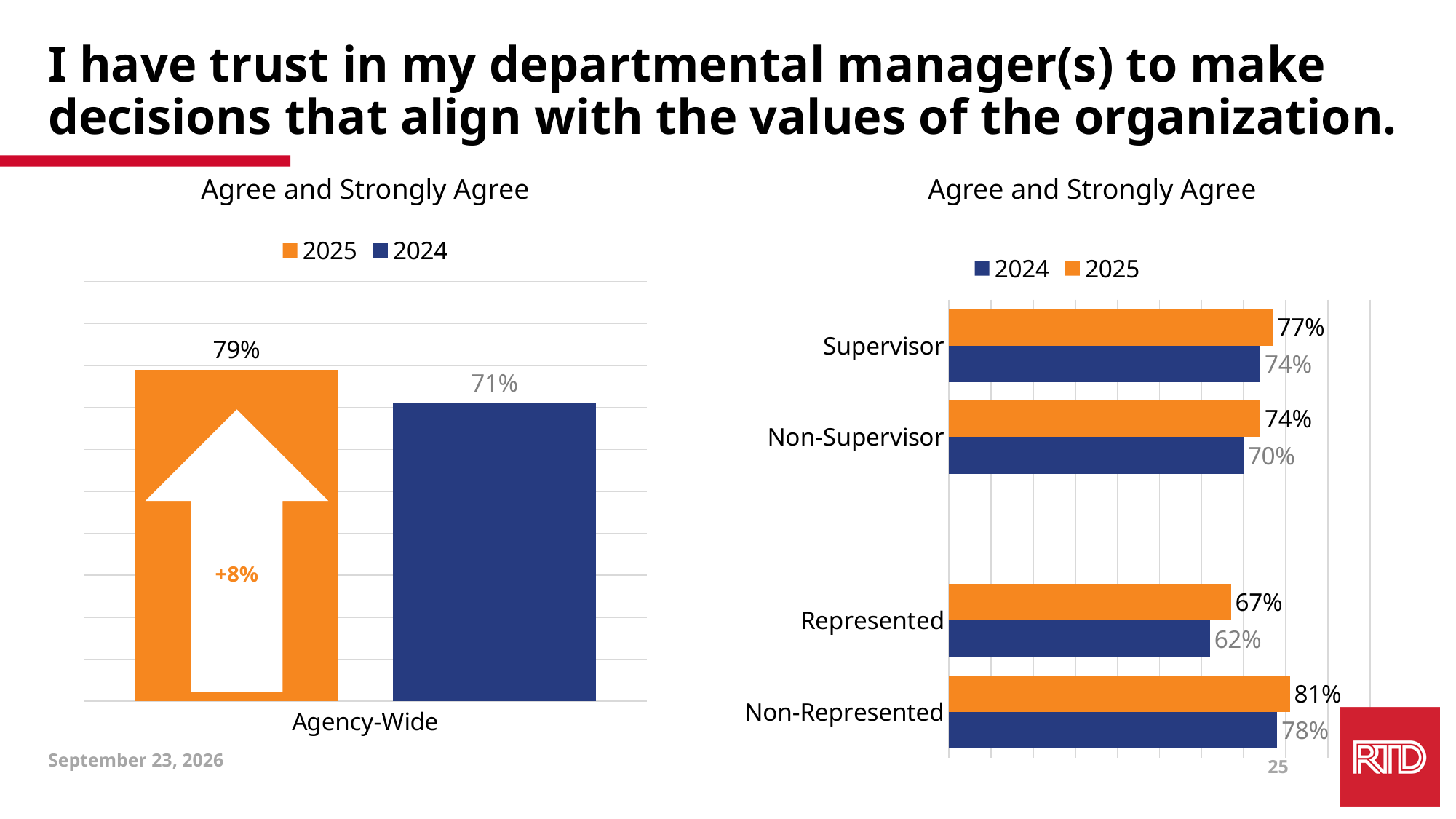
In the right chart, which is larger: the 2025 value for Represented or the 2024 value for Non-Represented? 2024 value for Non-Represented In the left chart, what is the 2024 value for Agency-Wide? 71% In the right chart, how many categories are shown? 4 In the right chart, what is the 2024 value for Represented? 62% In the right chart, what is the 2025 value for Supervisor? 77% What kind of chart is the right chart? Bar chart In the left chart, how many series does the legend list? 2 In the right chart, what is the difference between the 2025 and 2024 values for Non-Supervisor? 4% In the left chart, what is the difference between the 2025 and 2024 Agency-Wide values? 8% In the left chart, what is the 2025 value for Agency-Wide? 79% In the right chart, which category has the lowest 2024 value? Represented In the right chart, which category has the highest 2025 value? Non-Represented